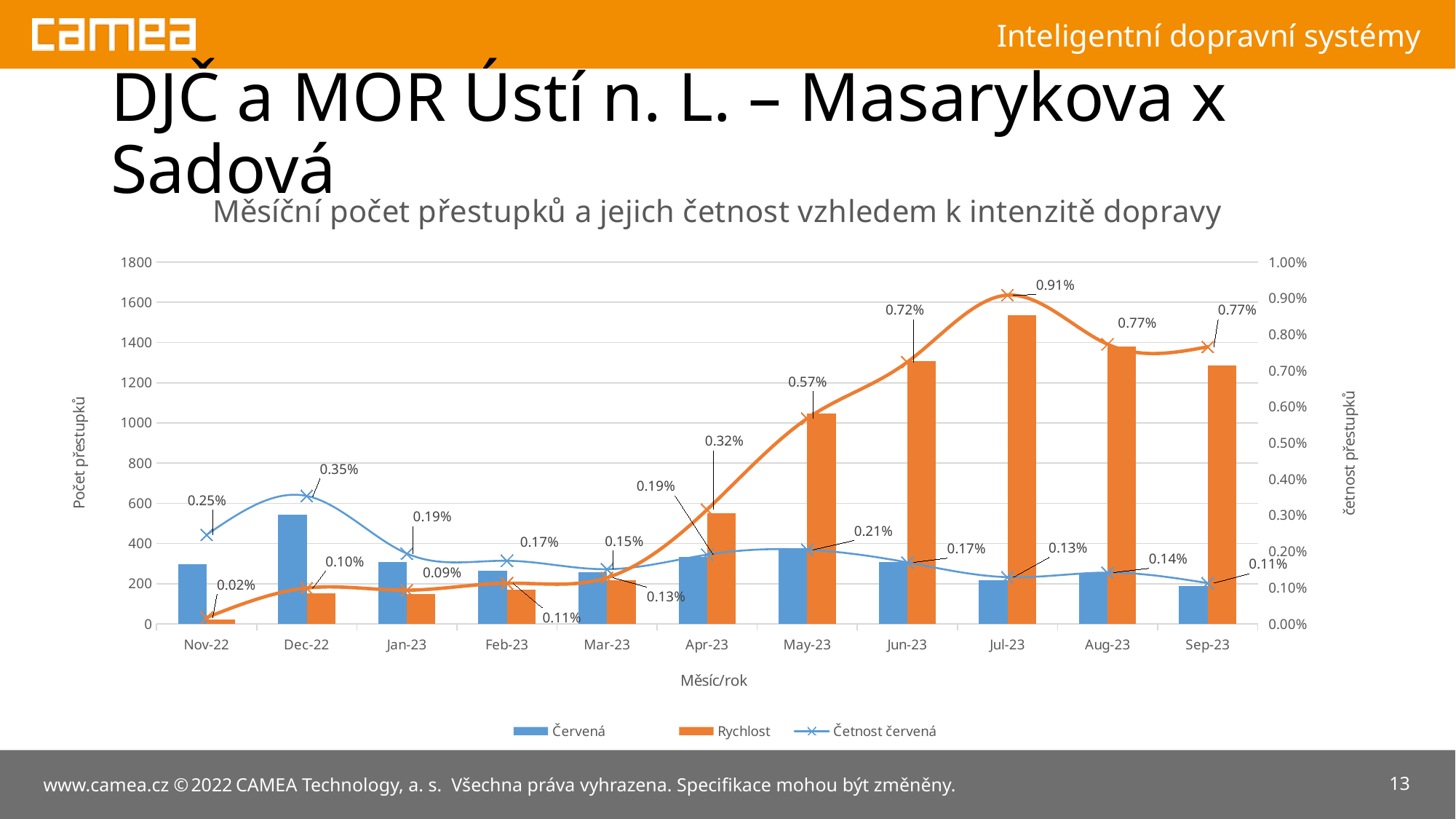
Is the Rychlost bar for Jul-23 greater or less than 1400? greater What is the Četnost červená value for Dec-22? 0.35% Is the Červená bar for Dec-22 greater or less than 400? greater In which month is the Rychlost bar highest? Jul-23 How many series does the legend list? 3 In which month is the Četnost červená value highest? Dec-22 How many months are shown on the x axis? 11 Is the Rychlost bar for Nov-22 greater or less than 200? less What is the difference between the Četnost červená values for Dec-22 and Sep-23? 0.24% What is the Četnost červená value for Sep-23? 0.11% In which month is the Četnost červená value lowest? Sep-23 Which is larger, the Četnost červená value for Nov-22 or for Jan-23? Nov-22